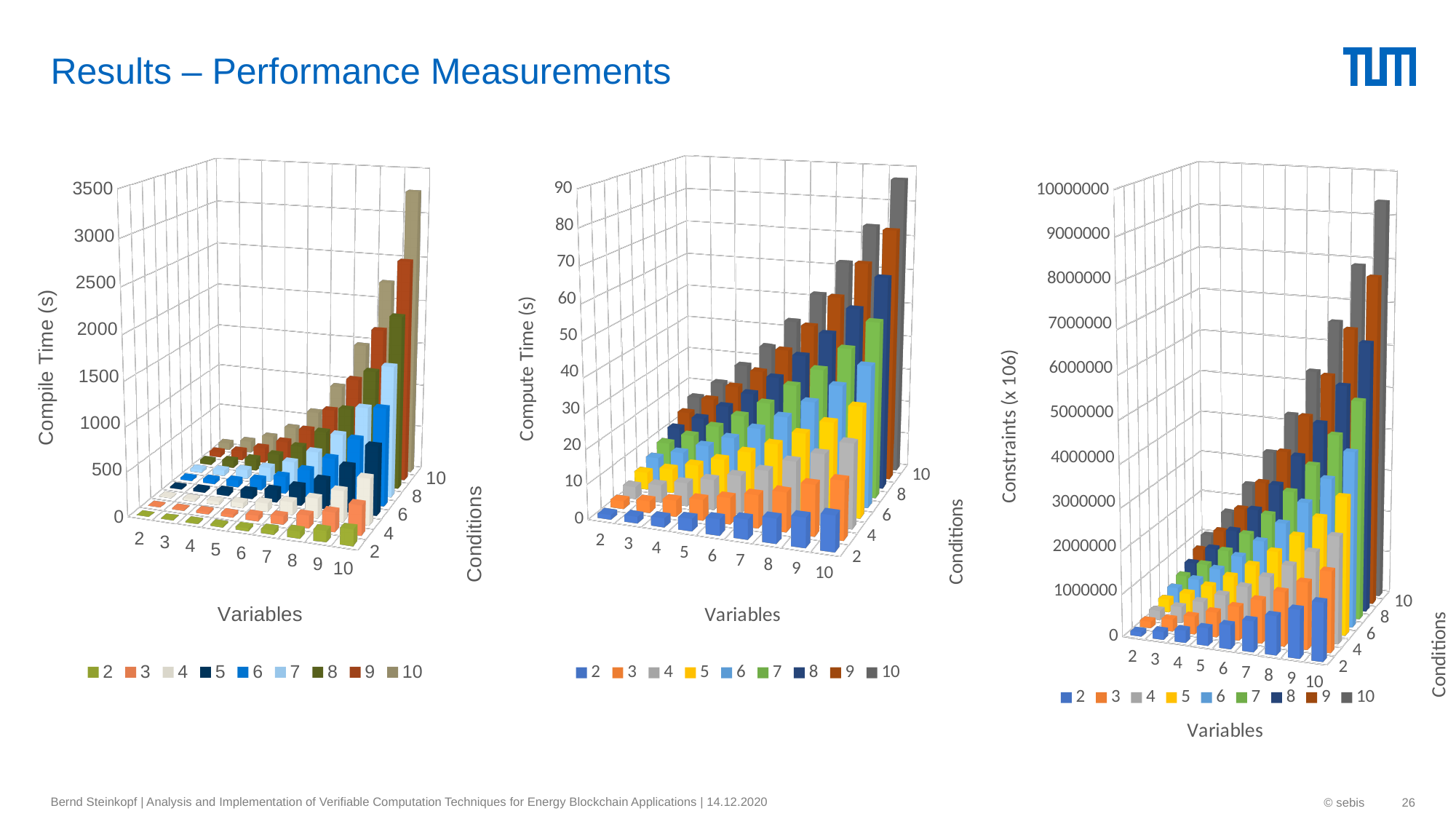
In the right chart, is the number of constraints for 2 variables with 2 conditions greater or less than 1000000? less In the right chart, which is larger: the constraints for 10 variables with 10 conditions or for 2 variables with 10 conditions? 10 variables with 10 conditions How many Variables categories are shown on the x axis of the right chart? 9 How many series does the legend of the middle chart list? 9 In the middle chart, is the compute time for 2 variables with 2 conditions greater or less than 10? less In the middle chart, which Variables category has the highest compute time for the 10-conditions series? 10 What is the y-axis title of the middle chart? Compute Time (s) What kind of chart is the left chart on the slide? bar chart In the left chart, do the compile times for the 10-conditions series rise or fall as the number of variables increases from 2 to 10? rise What is the y-axis title of the left chart? Compile Time (s) In the right chart, which Variables category has the lowest number of constraints for the 2-conditions series? 2 In the left chart, is the compile time for 2 variables with 2 conditions greater or less than 500? less